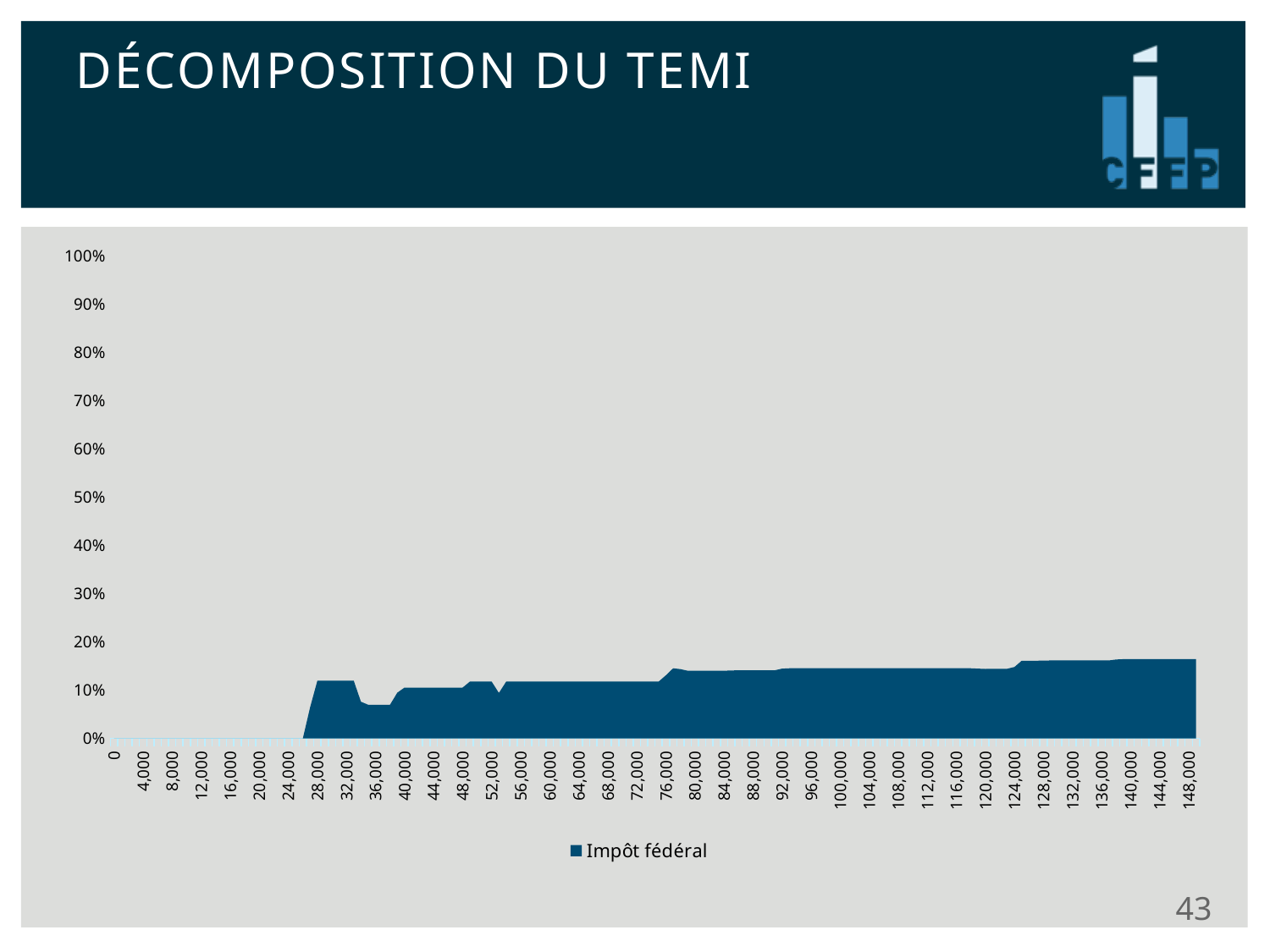
What kind of chart is shown on the slide? Area chart Is the value for Impôt fédéral at 100,000 greater or less than 20%? less Which is larger, the value for Impôt fédéral at 8,000 or at 80,000? 80,000 Which is larger, the value for Impôt fédéral at 36,000 or at 148,000? 148,000 Overall, do the values for Impôt fédéral rise or fall as income increases along the x axis? rise What is the title of the slide containing the chart? DÉCOMPOSITION DU TEMI Is the value for Impôt fédéral at 100,000 greater or less than 10%? greater Is the value for Impôt fédéral at 36,000 greater or less than 10%? less How many series does the legend list? 1 What is the name of the series shown in the legend? Impôt fédéral